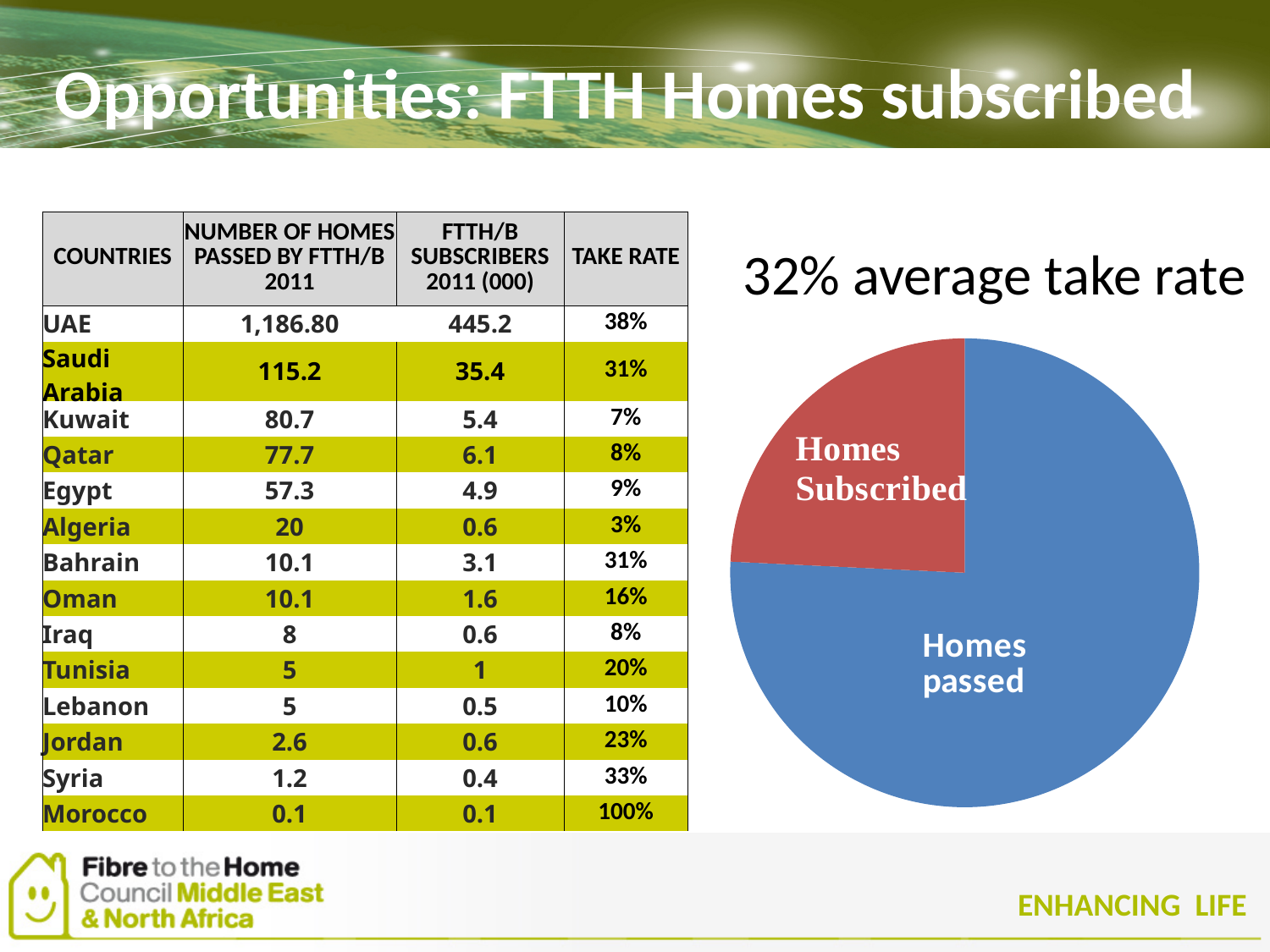
Which slice of the pie chart is the smallest? Homes Subscribed What text appears directly above the pie chart? 32% average take rate What colour is the Homes Subscribed slice in the pie chart? red How many slices does the pie chart have? 2 Which slice of the pie chart is the largest? Homes passed Which slice of the pie chart is larger, Homes passed or Homes Subscribed? Homes passed What kind of chart is shown on the right side of the slide? pie chart